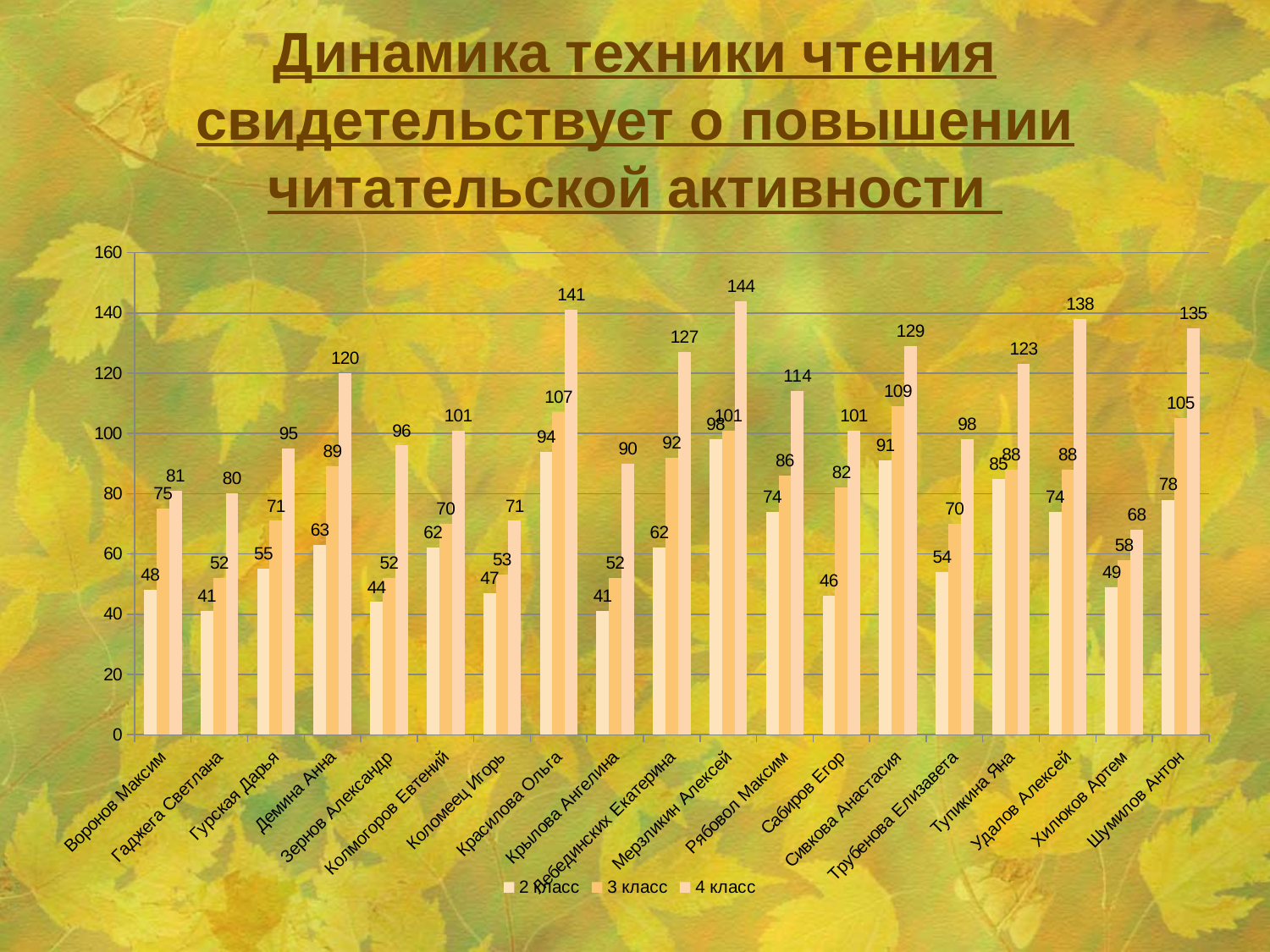
What is the difference between the 4 класс and 2 класс values for Удалов Алексей? 64 Which student has the lowest value in the 4 класс series? Хилюков Артем What is the value for Сабиров Егор in the 3 класс series? 82 What is the value for Демина Анна in the 2 класс series? 63 What are the three legend entries of the chart? 2 класс, 3 класс, 4 класс Which is larger: the 4 класс value for Шумилов Антон or the 4 класс value for Сивкова Анастасия? Шумилов Антон How many students (categories) are shown on the x axis? 19 What is the value for Красилова Ольга in the 4 класс series? 141 For Коломеец Игорь, do the values rise or fall from 2 класс to 4 класс? rise How many series does the legend list? 3 What type of chart is shown on the slide? bar chart Which student has the highest value in the 4 класс series? Мерзликин Алексей